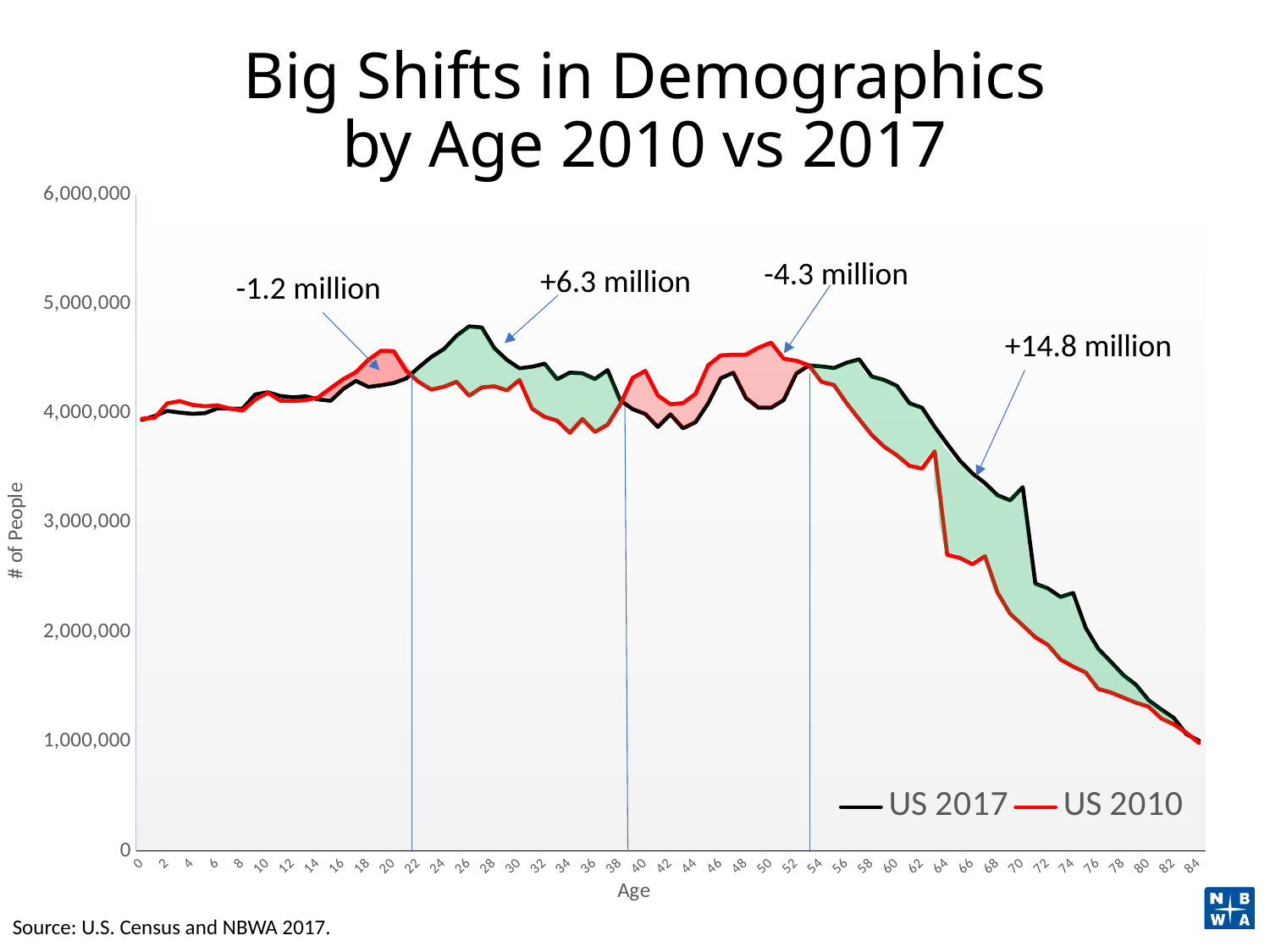
At age 66, which series has the higher value, US 2017 or US 2010? US 2017 What kind of chart is shown on the slide? line chart Do the values for US 2017 rise or fall along the x axis from age 54 to age 84? fall What is the title of the chart? Big Shifts in Demographics by Age 2010 vs 2017 Is the value for US 2017 at age 70 greater or less than 3,000,000? greater What are the two series named in the legend? US 2017 and US 2010 What change is annotated for the shaded region between ages 22 and 38? +6.3 million How many series does the legend list? 2 Which annotated change on the chart is the largest in magnitude? +14.8 million What change is annotated for the shaded region from age 54 onward? +14.8 million What change is annotated for the shaded region just before age 22? -1.2 million What change is annotated for the shaded region between ages 38 and 54? -4.3 million